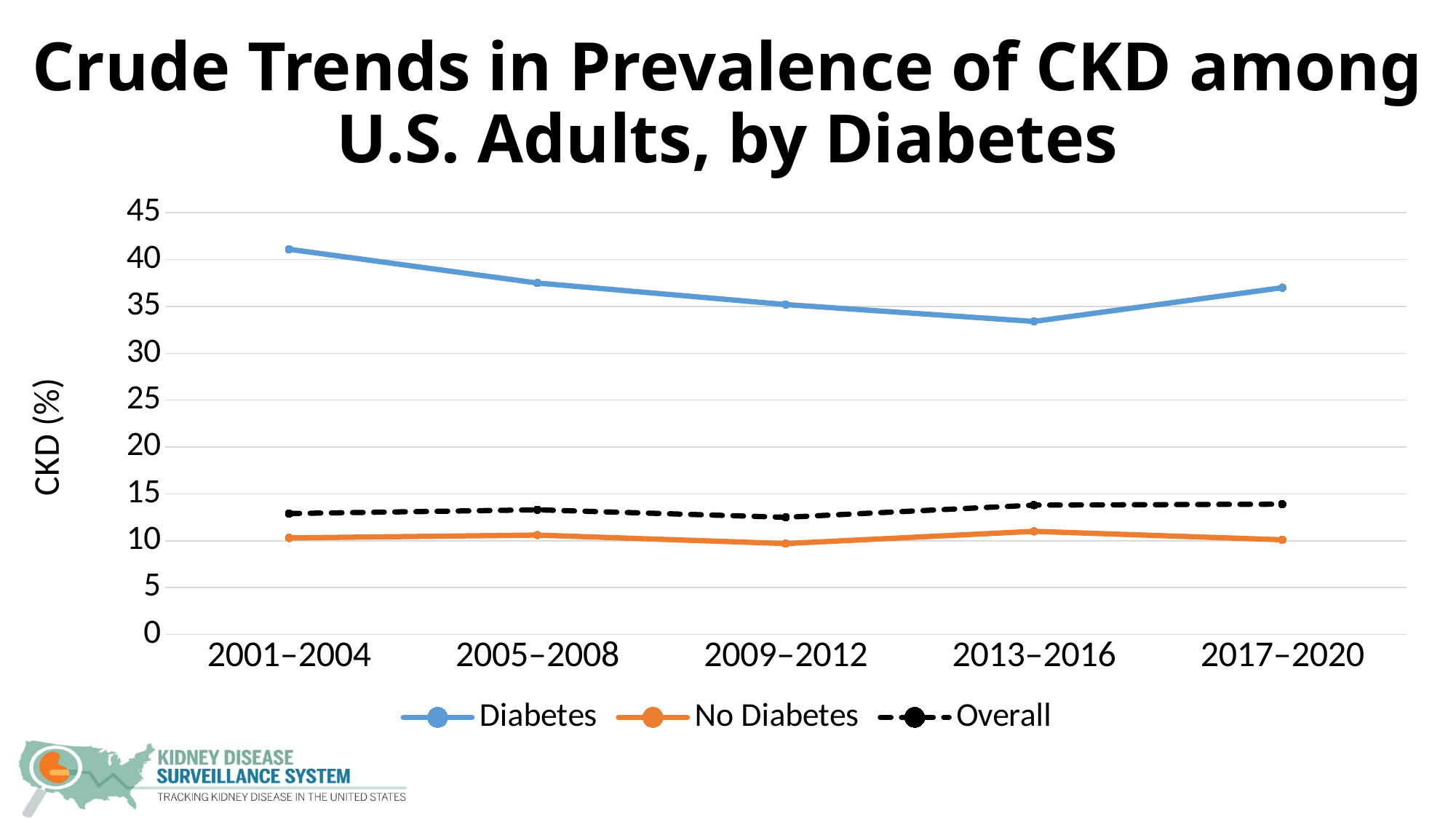
Does the Diabetes series rise or fall from 2001–2004 to 2013–2016? fall Which is larger in 2001–2004, the Diabetes value or the No Diabetes value? Diabetes Is the value for Diabetes in 2017–2020 greater or less than 35? greater What kind of chart is shown on the slide? line chart Which is larger in 2017–2020, the Overall value or the No Diabetes value? Overall Is the value for Overall in 2017–2020 greater or less than 15? less How many series does the legend list? 3 In which period is the Diabetes series at its lowest? 2013–2016 In which period is the Diabetes series at its highest? 2001–2004 What is the label on the y axis? CKD (%) Is the value for Diabetes in 2013–2016 greater or less than 35? less How many time periods are shown on the x axis? 5